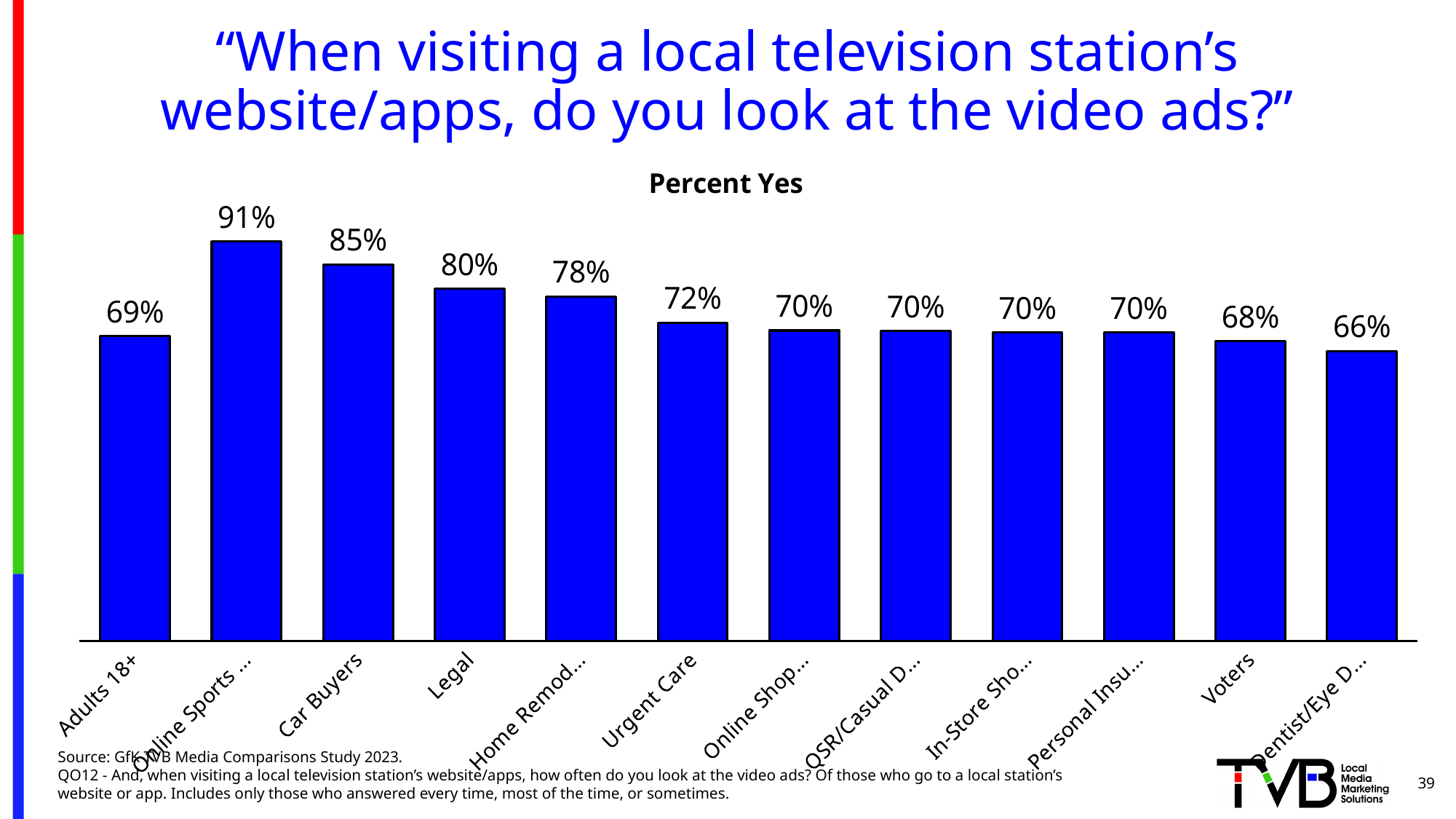
How many categories are shown on the chart? 12 What is the lowest Percent Yes value shown on the chart? 66% What is the highest Percent Yes value shown on the chart? 91% What kind of chart is shown on the slide? Bar chart Which has a higher Percent Yes, Legal or Urgent Care? Legal What is the Percent Yes value for Voters? 68% What is the Percent Yes value for Urgent Care? 72% What is the difference in Percent Yes between Car Buyers and Adults 18+? 16% What is the Percent Yes value for Car Buyers? 85% What is the Percent Yes value for Adults 18+? 69% What is the Percent Yes value for Legal? 80% What is the title of the chart? Percent Yes